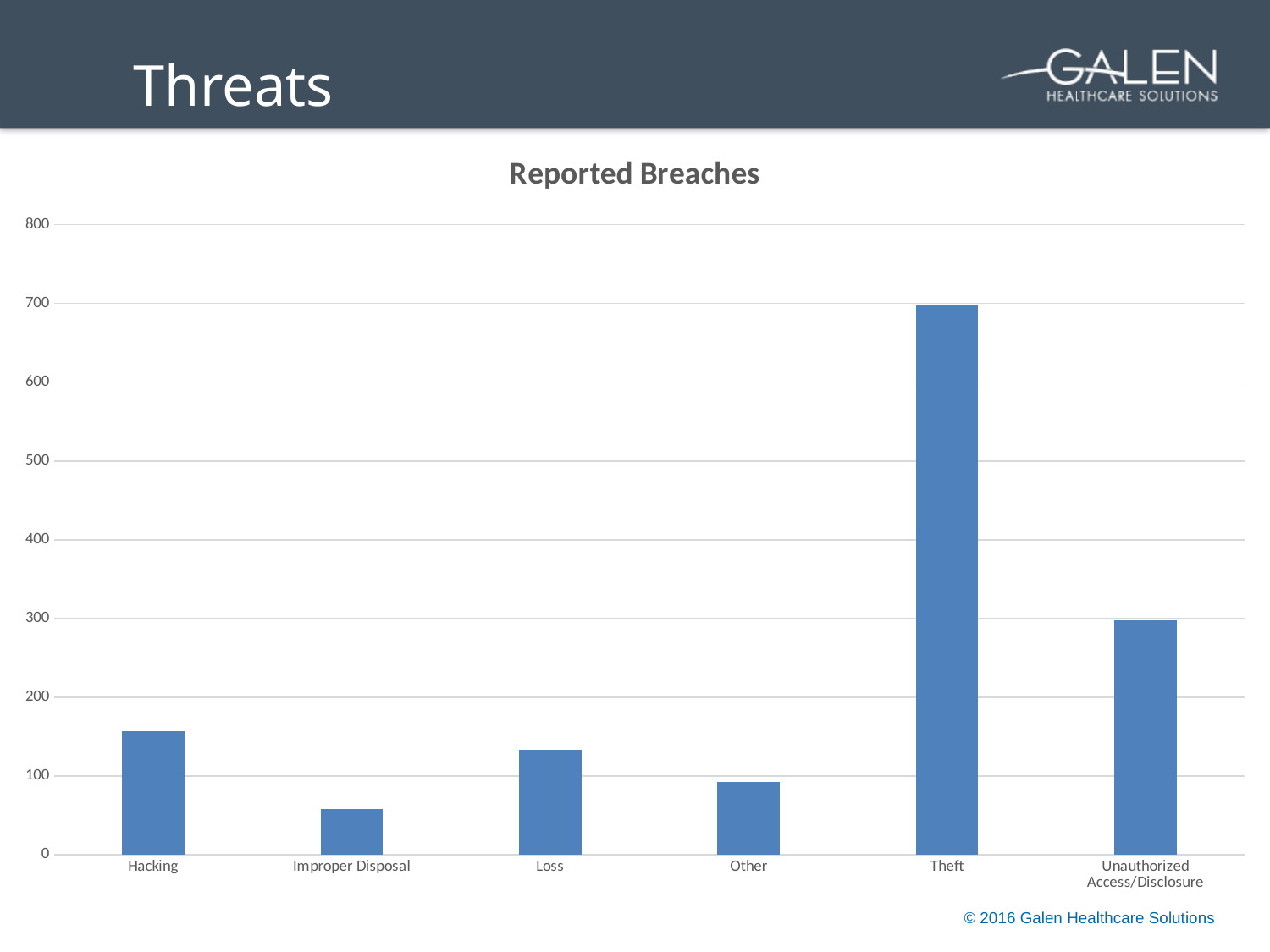
Which has more reported breaches, Hacking or Loss? Hacking Which category has the highest number of reported breaches? Theft Is the value for Hacking greater or less than 100? greater Which category has the lowest number of reported breaches? Improper Disposal Which has more reported breaches, Other or Improper Disposal? Other How many categories are shown on the x axis of the chart? 6 What is the title of the chart? Reported Breaches Is the value for Improper Disposal greater or less than 100? less Is the value for Hacking greater or less than 200? less What type of chart is shown on the slide? bar chart